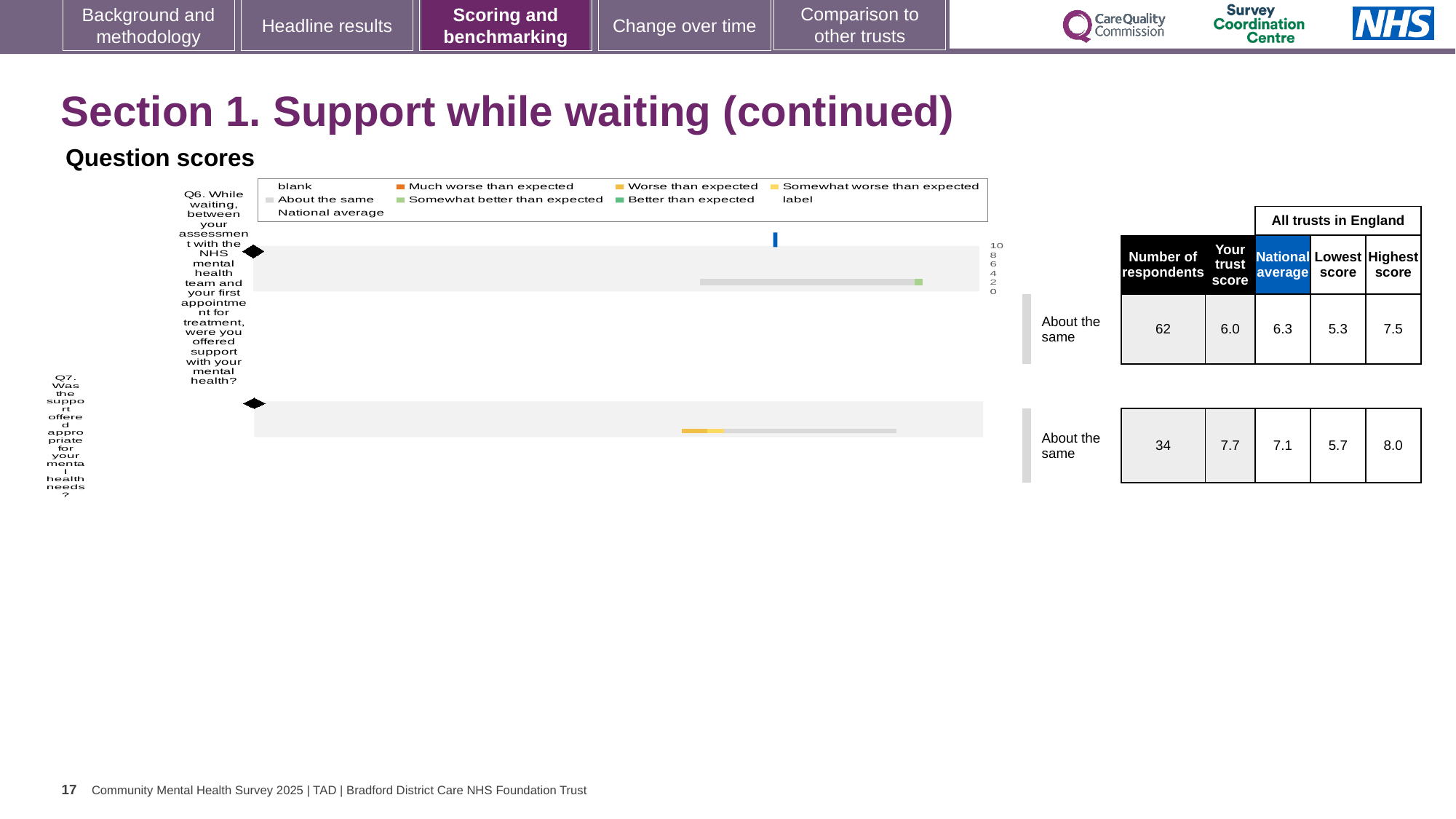
What benchmark category is shown for both Q6 and Q7 next to the chart? About the same In the table beside the chart, what is the highest score for Q7? 8.0 In the table beside the chart, what is your trust score for Q7? 7.7 How many entries does the chart's legend list? 9 In the table beside the chart, what is the number of respondents for Q6? 62 What kind of chart is shown under "Question scores"? bar chart What is the maximum value shown on the chart's axis? 10 In the table beside the chart, which question has the higher trust score, Q6 or Q7? Q7 In the table beside the chart, what is the difference between the highest and lowest score for Q6? 2.2 In the table beside the chart, what is the national average for Q6? 6.3 How many questions (categories) are plotted in the chart? 2